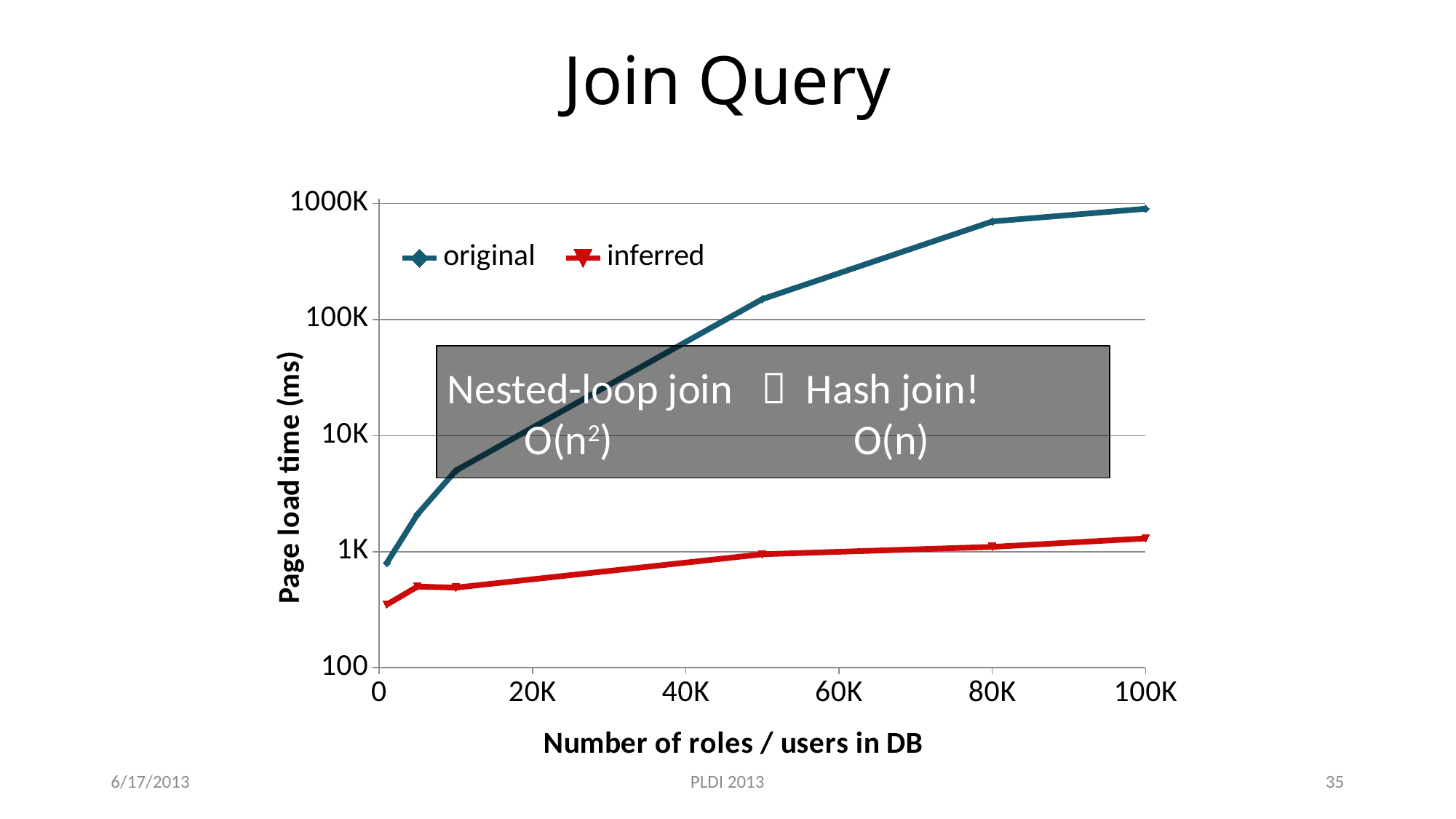
What kind of chart is shown on the slide? line chart Is the page load time for the inferred series at 10K roles/users greater or less than 1K ms? less Which series has the lower page load time at 80K roles/users? inferred Does the page load time for the original series rise or fall as the number of roles/users increases? rise What are the two series named in the legend? original and inferred Is the page load time for the inferred series at 100K roles/users greater or less than 1K ms? greater Which series has the higher page load time at 100K roles/users? original How many series does the legend list? 2 Does the page load time for the inferred series rise or fall as the number of roles/users increases from 20K to 100K? rise Is the page load time for the original series at 50K roles/users greater or less than 100K ms? greater What is the title of the chart slide? Join Query